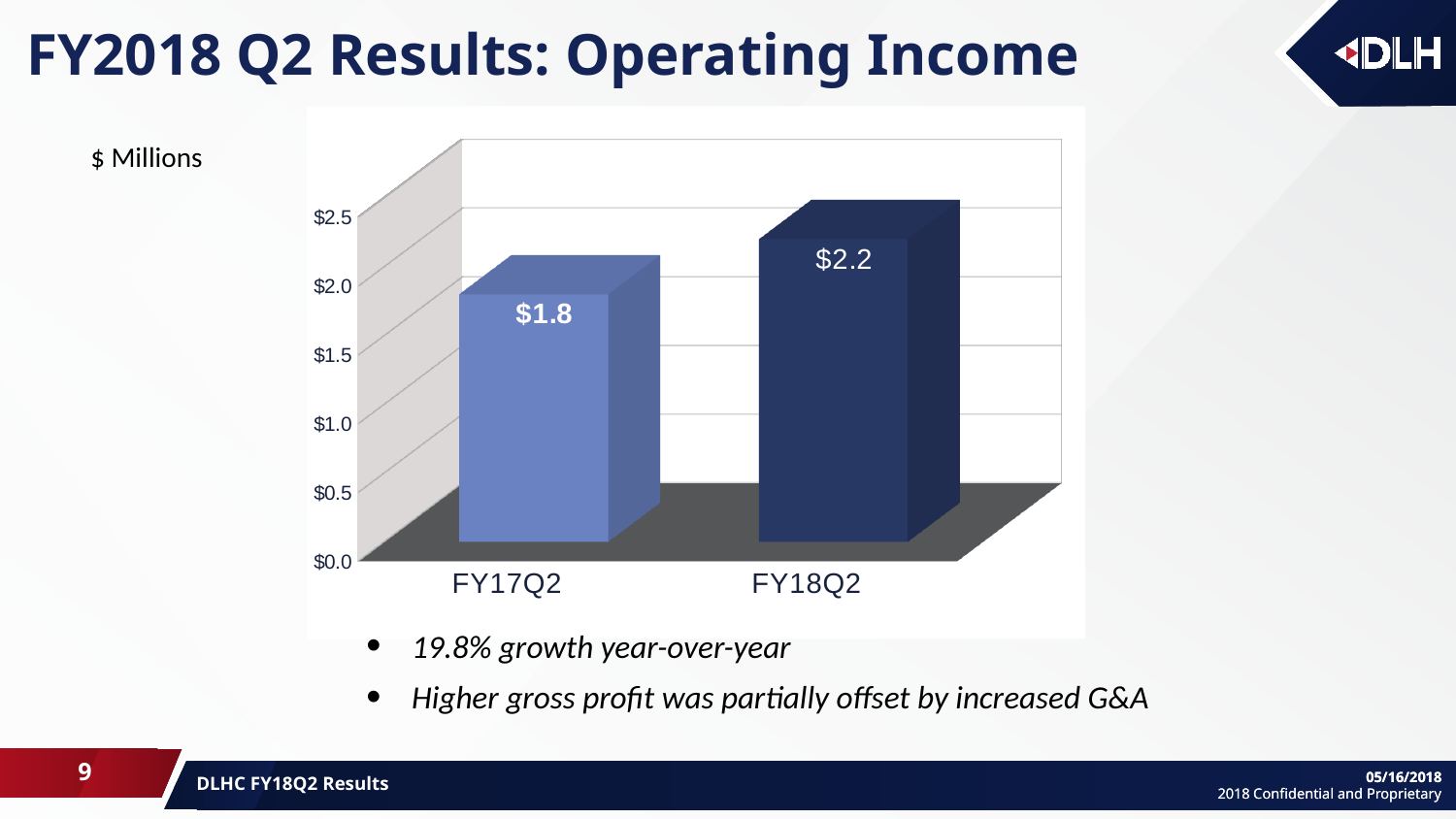
Do the values rise or fall from FY17Q2 to FY18Q2? rise What kind of chart is shown on the slide? bar chart What is the operating income value for FY18Q2? $2.2 Is the operating income for FY18Q2 larger or smaller than for FY17Q2? larger Is the value for FY18Q2 greater or less than $2.0? greater How many categories are shown on the x axis of the chart? 2 What is the operating income value for FY17Q2? $1.8 What unit is indicated for the values in the chart? $ Millions What is the difference between the FY18Q2 and FY17Q2 operating income values? $0.4 Which quarter has the higher operating income? FY18Q2 Which quarter has the lower operating income? FY17Q2 Is the value for FY17Q2 greater or less than $2.0? less